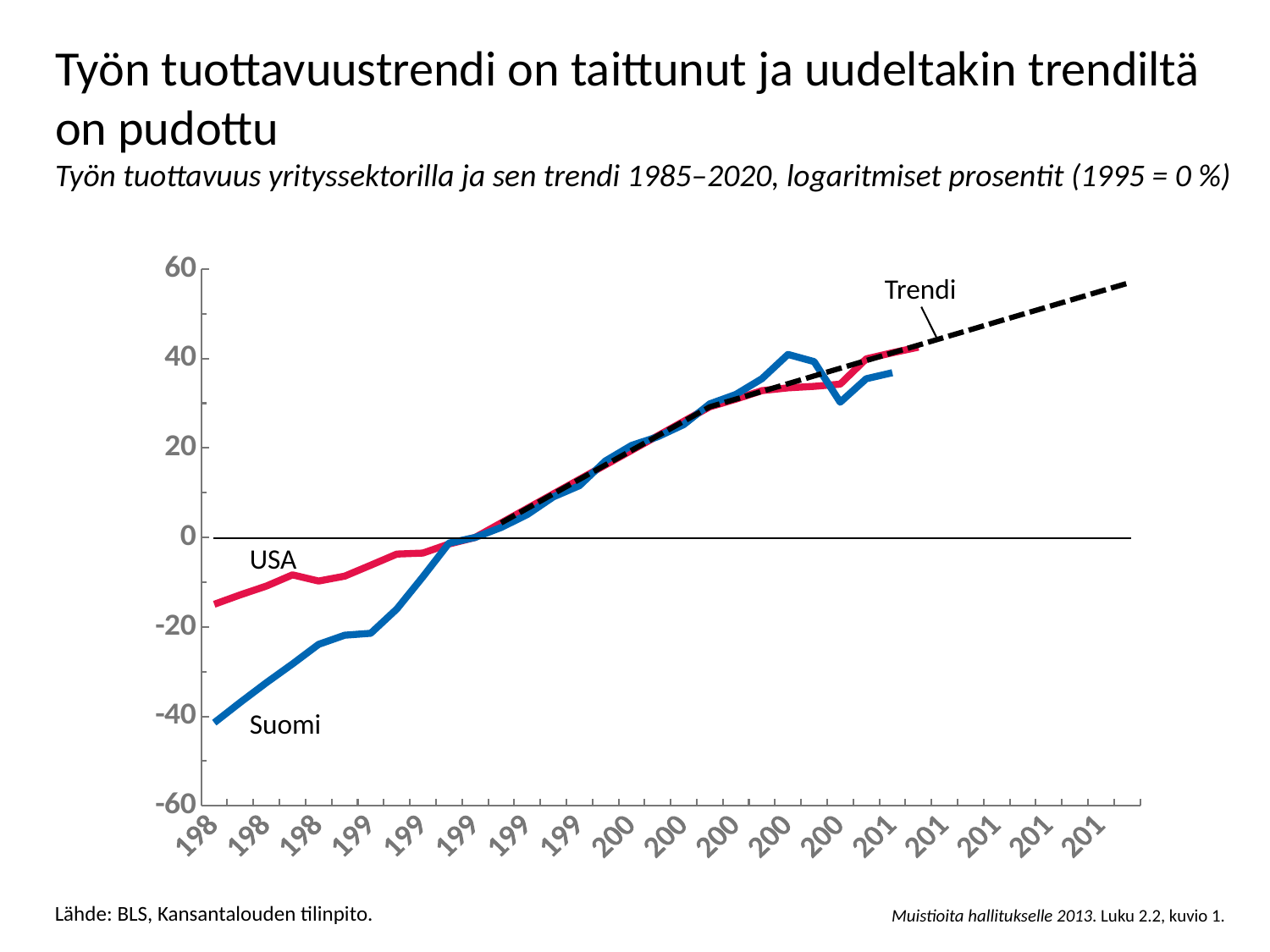
What is the highest value shown on the y axis? 60 At the left end of the chart, which line is higher, USA or Suomi? USA Does the Suomi line generally rise or fall from left to right? rise What kind of chart is shown on the slide? line chart What colour is the USA line? red At the right end of the chart, which is higher, the Trendi line or the Suomi line? Trendi Is the leftmost value of the USA line greater or less than -20? greater Is the leftmost value of the Suomi line greater or less than -20? less Is the rightmost value of the Trendi line greater or less than 40? greater How many series are labelled on the chart? 3 What are the names of the three series labelled on the chart? USA, Suomi, Trendi Which series has the lowest value at the start of the chart? Suomi